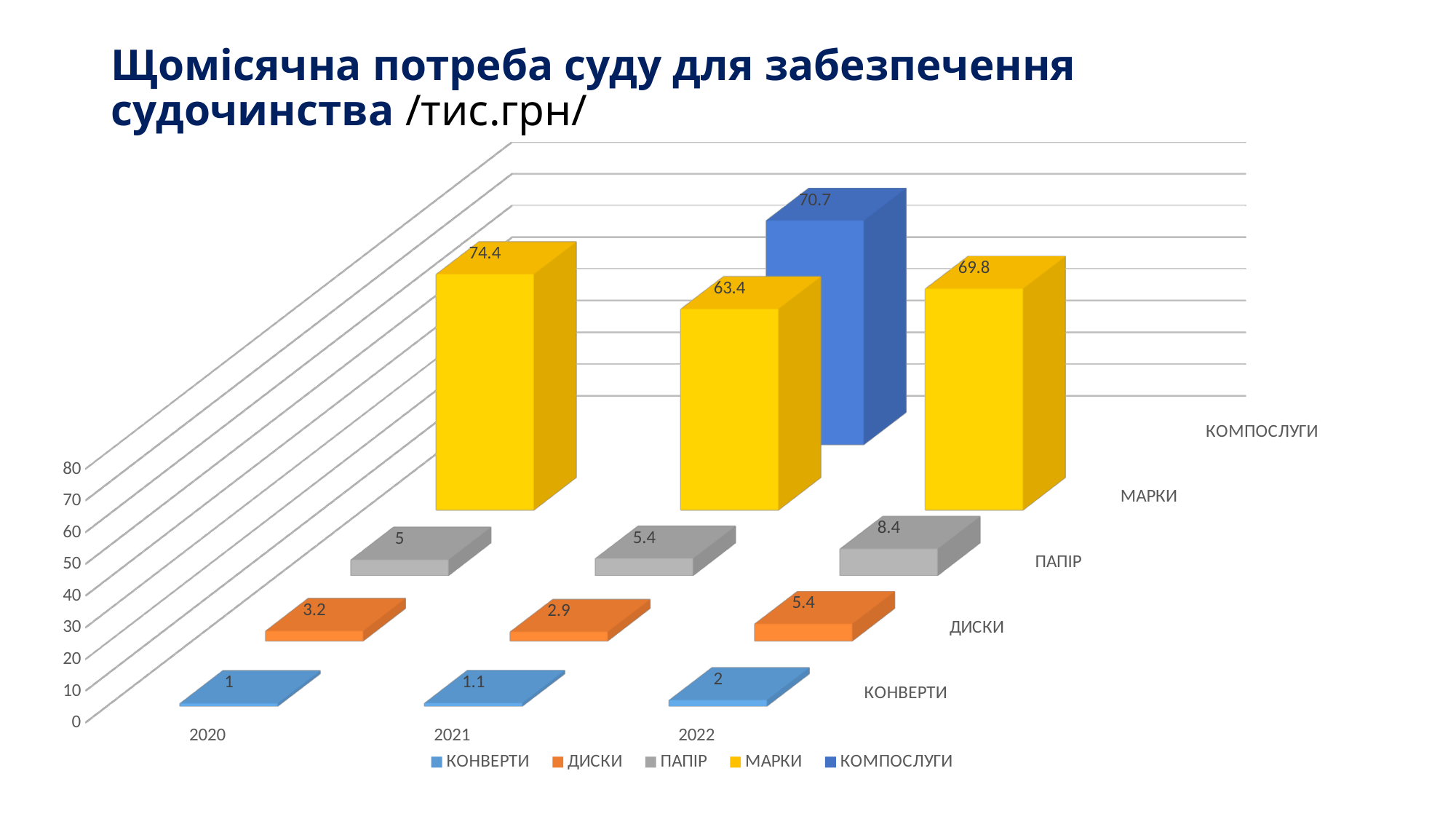
What is the difference between the МАРКИ values for 2020 and 2022? 4.6 Do the values for КОНВЕРТИ rise or fall from 2020 to 2022? rise What type of chart is shown on the slide? bar chart In which year is the value for МАРКИ the lowest? 2021 Which is larger, the ПАПІР value for 2021 or the ДИСКИ value for 2022? They are equal (5.4) What is the value for КОМПОСЛУГИ in 2021? 70.7 What is the value for МАРКИ in 2020? 74.4 What is the value for ПАПІР in 2022? 8.4 What is the value for ДИСКИ in 2021? 2.9 In which year is the value for ДИСКИ the highest? 2022 How many series does the legend list? 5 What is the value for КОНВЕРТИ in 2022? 2